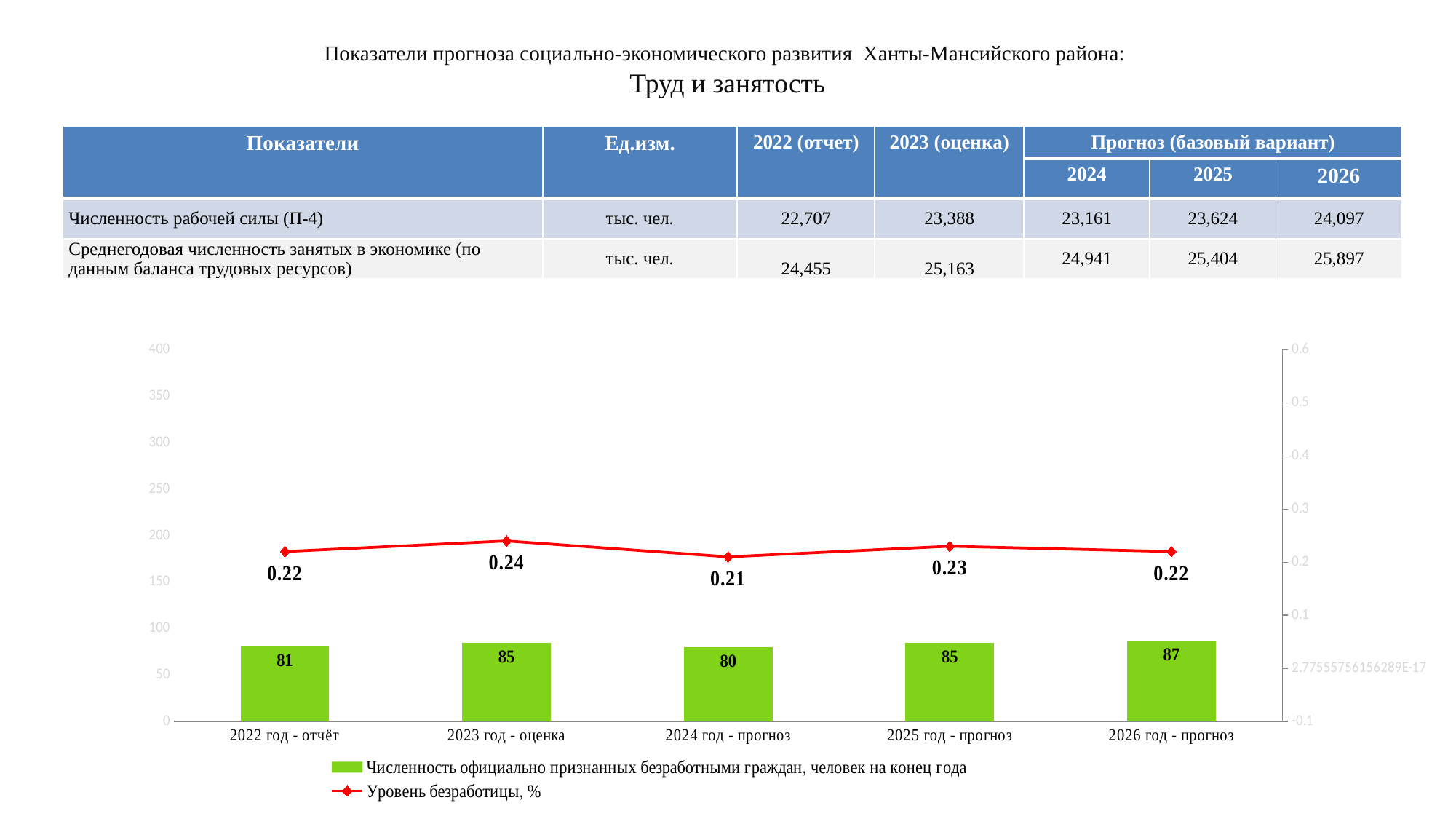
How many series does the chart legend list? 2 How many years (categories) are shown on the x axis of the chart? 5 Is the number of officially recognised unemployed citizens higher in 2023 год - оценка or in 2024 год - прогноз? 2023 год - оценка What is the difference in the number of officially recognised unemployed citizens between 2026 год - прогноз and 2024 год - прогноз? 7 Which year has the highest number of officially recognised unemployed citizens? 2026 год - прогноз Which year has the highest unemployment rate (Уровень безработицы, %)? 2023 год - оценка Is the number of officially recognised unemployed citizens for 2025 год - прогноз greater or less than 100? less What is the number of officially recognised unemployed citizens for 2026 год - прогноз? 87 What colour are the bars for the number of officially recognised unemployed citizens? Green Which year has the lowest unemployment rate (Уровень безработицы, %)? 2024 год - прогноз What is the unemployment rate (Уровень безработицы, %) for 2024 год - прогноз? 0.21 What is the number of officially recognised unemployed citizens (Численность официально признанных безработными граждан) for 2022 год - отчёт? 81